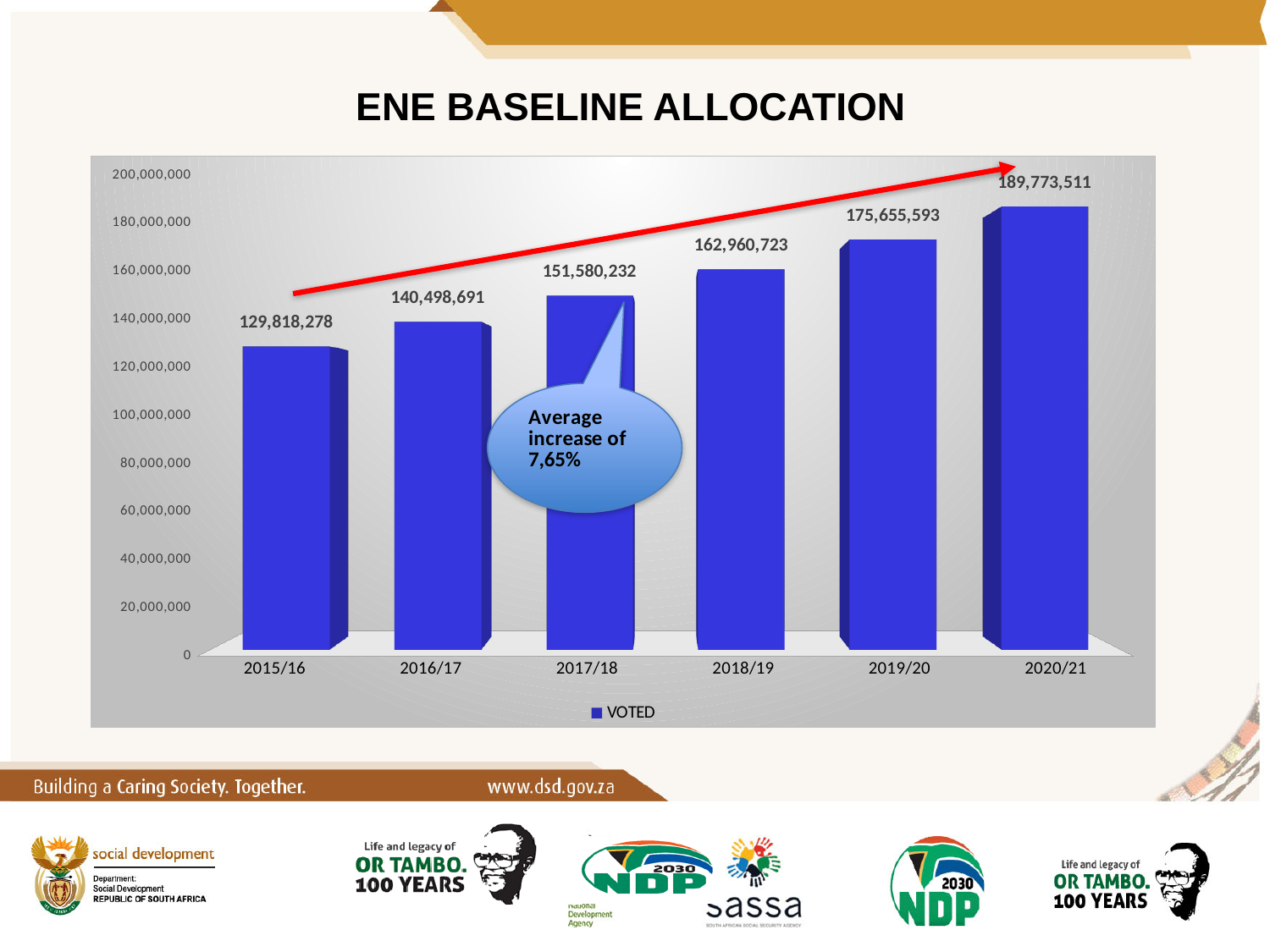
Which year has the lowest voted allocation? 2015/16 Which is larger, the allocation for 2018/19 or for 2016/17? 2018/19 What is the difference between the 2020/21 and 2015/16 allocations? 59,955,233 What kind of chart is shown on the slide? Bar chart How many series does the legend list? 1 Do the allocations rise or fall from 2015/16 to 2020/21? Rise What is the voted allocation for 2017/18? 151,580,232 How many financial years are shown on the chart? 6 Which year has the highest voted allocation? 2020/21 What is the voted allocation for 2019/20? 175,655,593 Is the value for 2017/18 greater or less than 140,000,000? greater By how much did the allocation increase from 2015/16 to 2016/17? 10,680,413